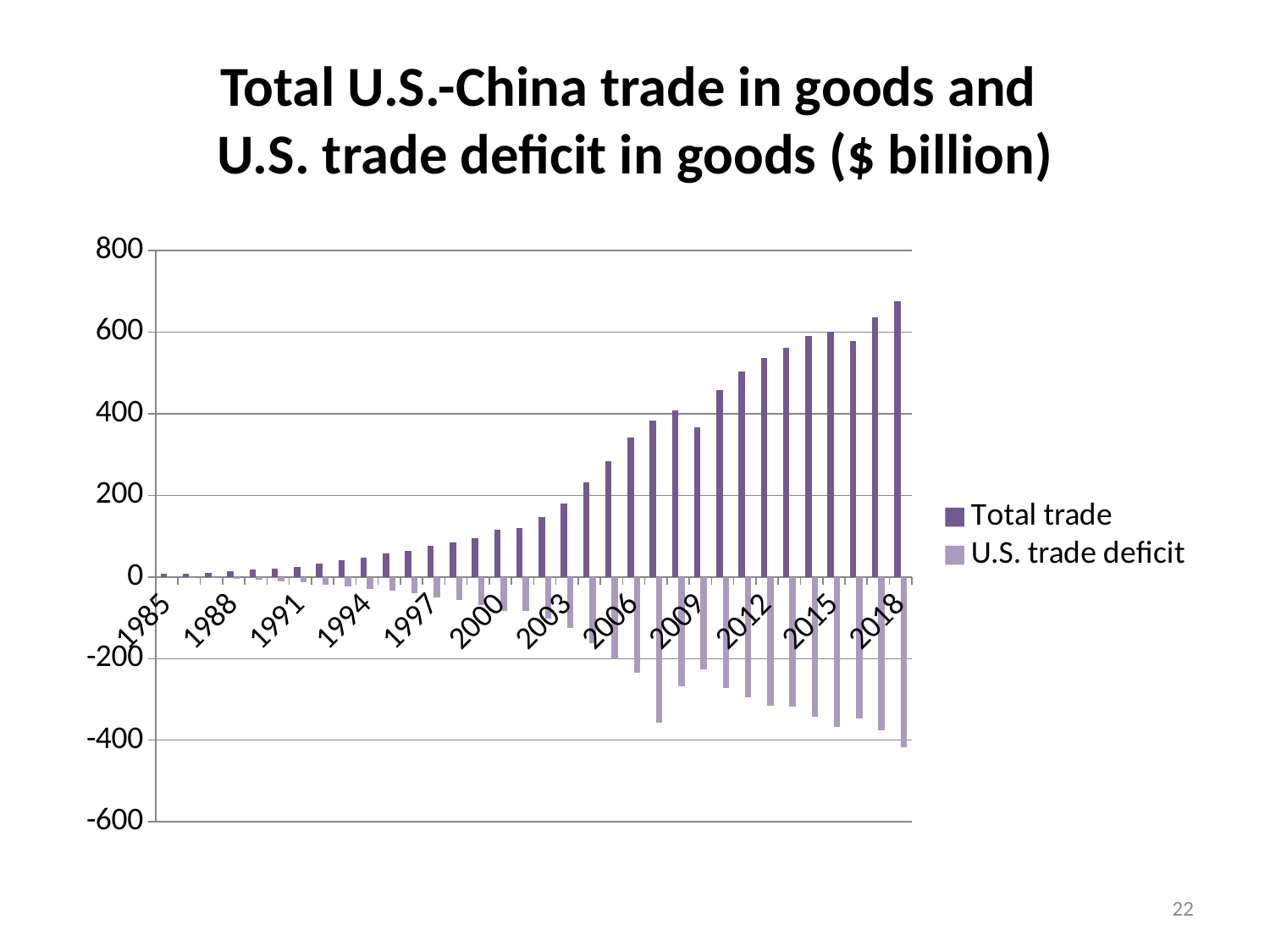
Is the Total trade value for 2009 greater or less than 400? less In which year is Total trade highest? 2018 In which year is the U.S. trade deficit bar the lowest (most negative)? 2018 How many series does the legend list? 2 Is the Total trade value for 2012 greater or less than 400? greater Overall, does Total trade rise or fall from 1985 to 2018? rise What kind of chart is shown on the slide? bar chart Which year has the larger Total trade value, 2009 or 2012? 2012 What are the two series named in the legend? Total trade and U.S. trade deficit Is the Total trade value for 2018 greater or less than 600? greater